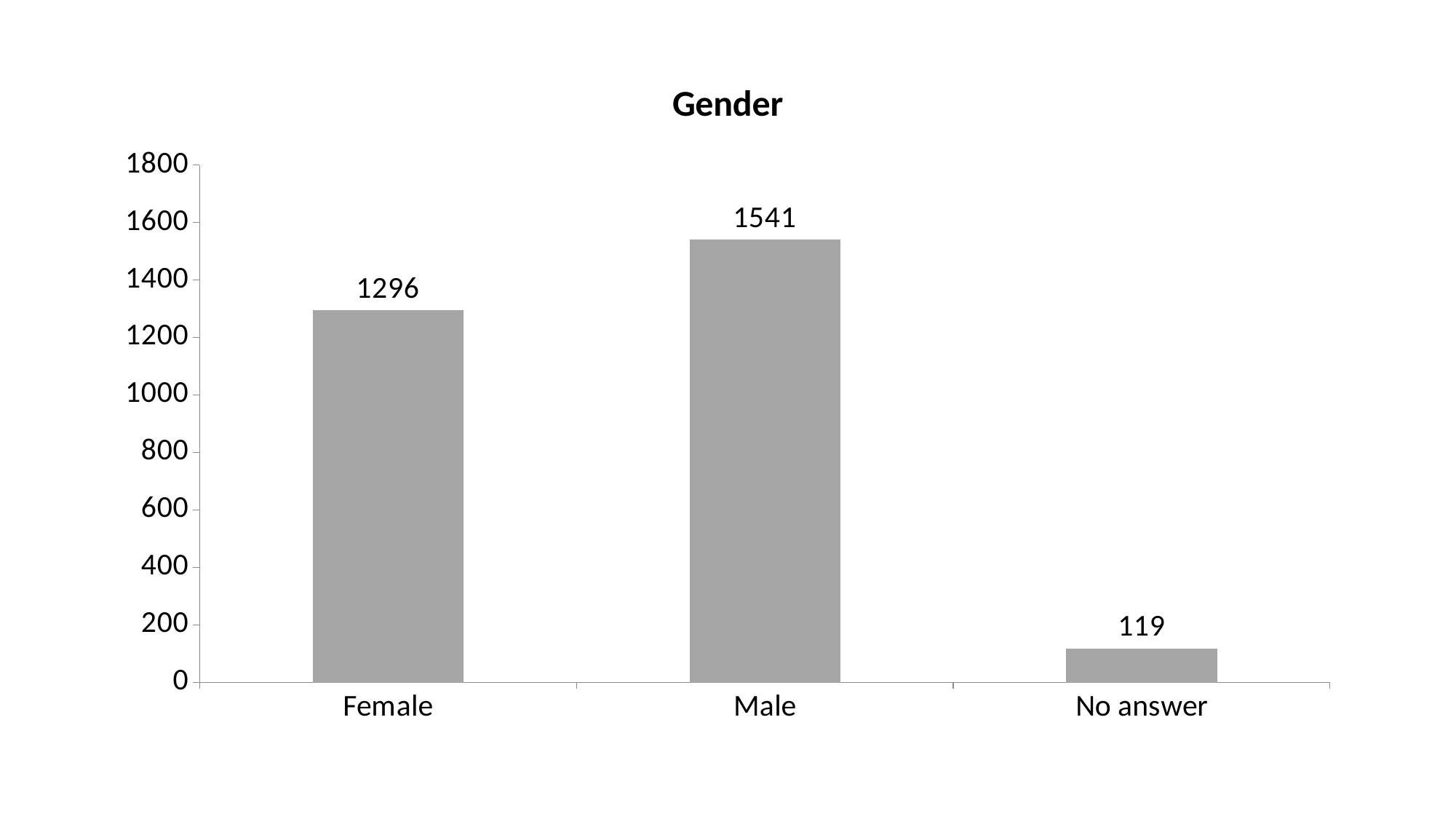
What is the difference between the values for Female and No answer? 1177 What is the title of the chart? Gender Is the value for Female greater or less than 1400? less What is the value for Female? 1296 What is the value for No answer? 119 Which category has the highest value? Male Which is larger, the value for Female or the value for Male? Male What is the value for Male? 1541 Which category has the lowest value? No answer How many categories are shown on the chart? 3 What is the difference between the values for Male and Female? 245 What kind of chart is shown on the slide? bar chart